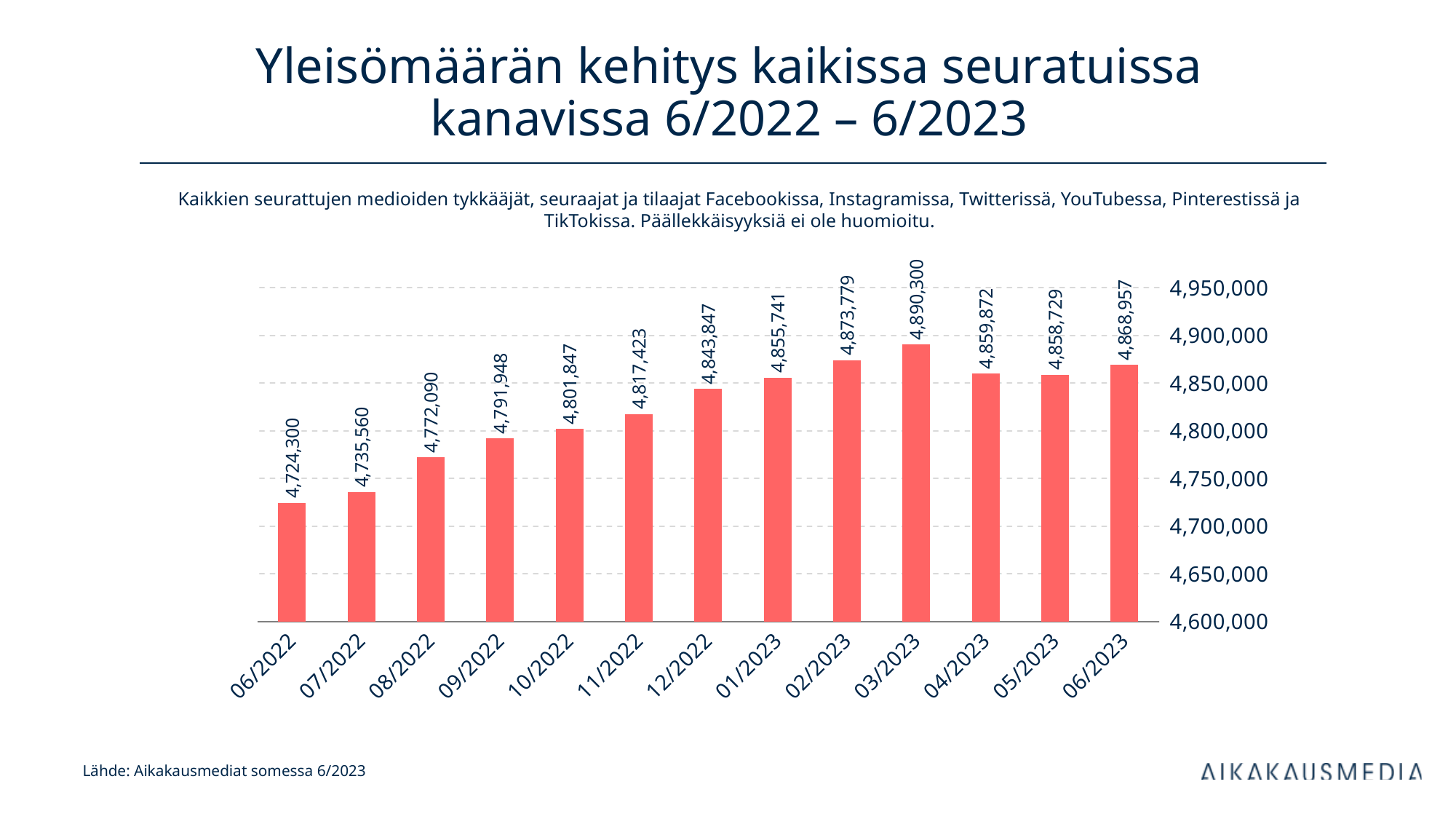
Which is larger, the value for 08/2022 or the value for 11/2022? 11/2022 What is the value for 12/2022? 4,843,847 What is the difference between the values for 03/2023 and 02/2023? 16,521 Which month has the lowest value? 06/2022 How many months are shown on the x axis? 13 What kind of chart is shown on the slide? bar chart What is the value for 03/2023? 4,890,300 Do the values generally rise or fall from 06/2022 to 03/2023? rise Which month has the highest value? 03/2023 Is the value for 06/2022 greater or less than 4,750,000? less What is the difference between the values for 06/2023 and 06/2022? 144,657 What is the value for 06/2022? 4,724,300